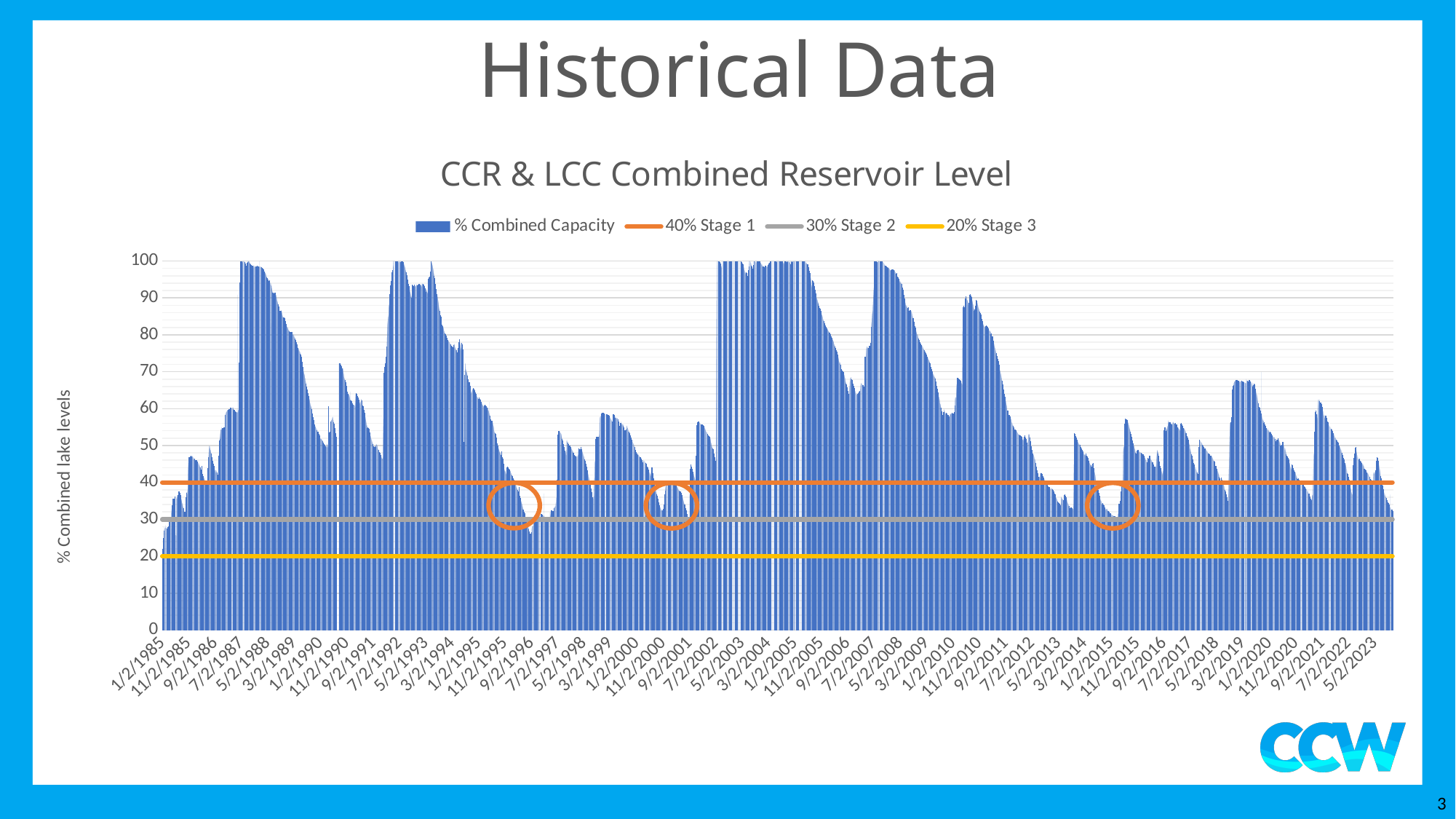
Is the % Combined Capacity value around 5/2/1987 greater or less than 90? greater Which is larger, the % Combined Capacity value around 5/2/1987 or around 9/2/1996? 5/2/1987 How many orange circles are drawn on the chart to highlight periods? 3 Does the % Combined Capacity rise or fall between 7/2/2007 and 9/2/2011? fall At what level is the 20% Stage 3 line drawn on the y axis? 20 What kind of chart is used to plot the % Combined Capacity series? bar chart Is the % Combined Capacity value around 9/2/2001 greater or less than 40? less What is the title of the chart? CCR & LCC Combined Reservoir Level Is the % Combined Capacity value around 3/2/2004 greater or less than 90? greater At what level is the 30% Stage 2 line drawn on the y axis? 30 How many series does the chart legend list? 4 At what level is the 40% Stage 1 line drawn on the y axis? 40